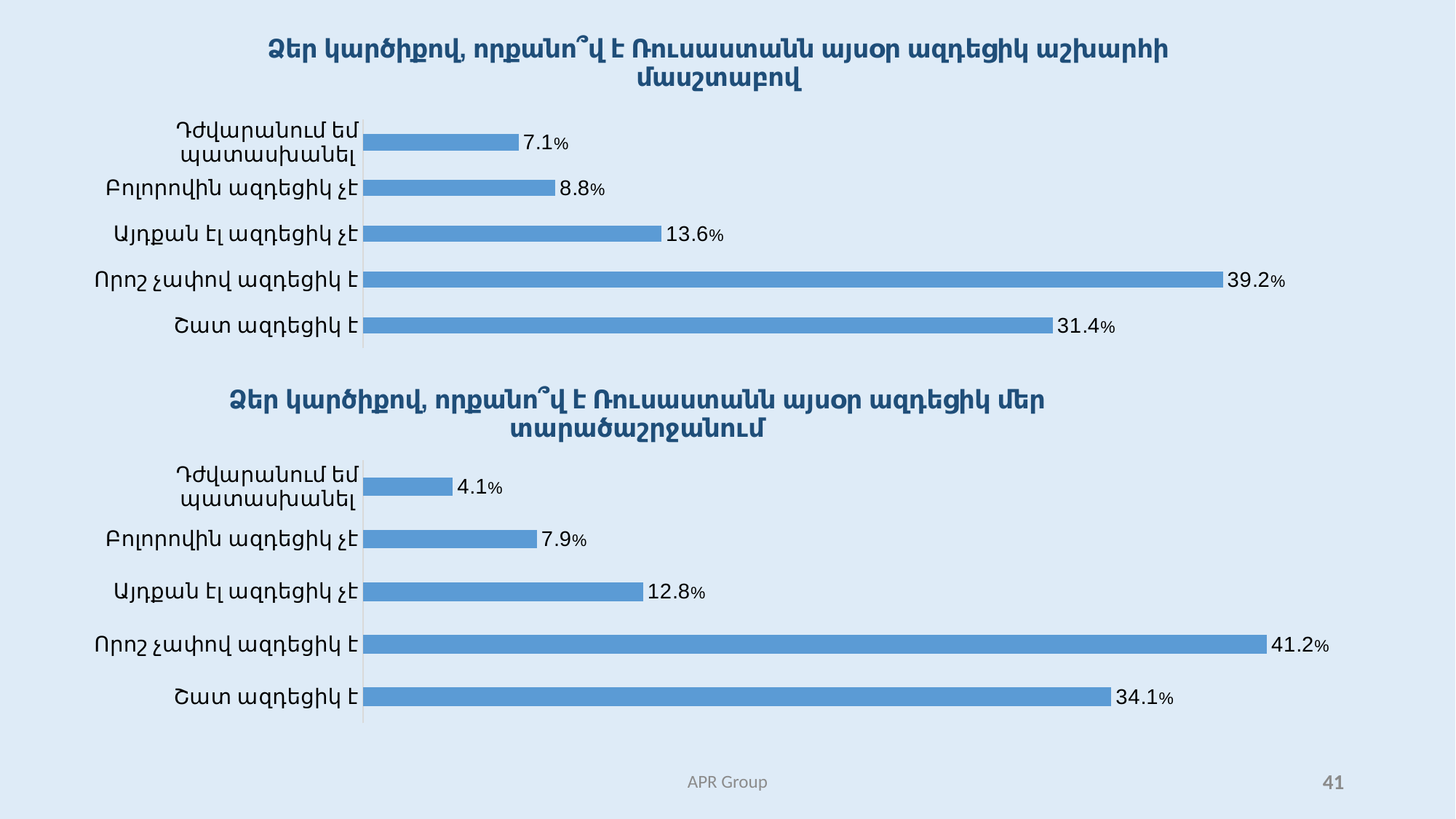
In the bottom chart (մեր տարածաշրջանում), what is the difference between "Այդքան էլ ազդեցիկ չէ" and "Բոլորովին ազդեցիկ չէ"? 4.9% In the top chart (աշխարհի մասշտաբով), what is the difference between "Որոշ չափով ազդեցիկ է" and "Շատ ազդեցիկ է"? 7.8% In the top chart (աշխարհի մասշտաբով), which category has the highest value? Որոշ չափով ազդեցիկ է Which is larger: "Շատ ազդեցիկ է" in the top chart or "Շատ ազդեցիկ է" in the bottom chart? Bottom chart (34.1%) In the bottom chart (մեր տարածաշրջանում), what is the value for "Որոշ չափով ազդեցիկ է"? 41.2% What is the title of the top chart? Ձեր կարծիքով, որքանո՞վ է Ռուսաստանն այսօր ազդեցիկ աշխարհի մասշտաբով In the top chart (աշխարհի մասշտաբով), what is the value for "Դժվարանում եմ պատասխանել"? 7.1% In the bottom chart (մեր տարածաշրջանում), which category has the lowest value? Դժվարանում եմ պատասխանել In the top chart (Ռուսաստանն այսօր ազդեցիկ աշխարհի մասշտաբով), what is the value for "Շատ ազդեցիկ է"? 31.4% In the bottom chart (մեր տարածաշրջանում), what is the value for "Բոլորովին ազդեցիկ չէ"? 7.9% How many categories does the top chart (աշխարհի մասշտաբով) show? 5 What type of chart is the bottom chart (մեր տարածաշրջանում)? Bar chart